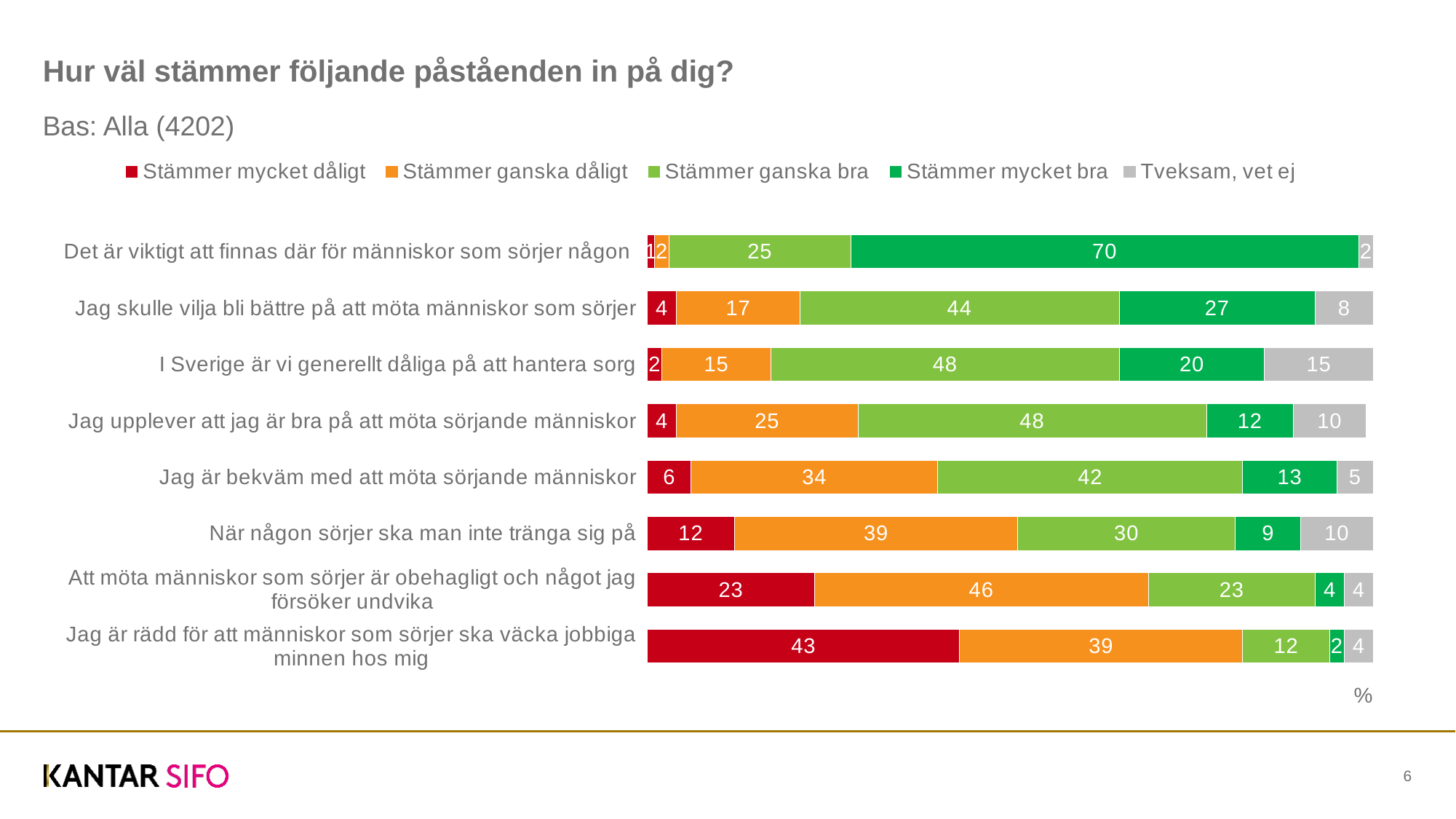
Which statement has the highest value for "Stämmer mycket dåligt"? Jag är rädd för att människor som sörjer ska väcka jobbiga minnen hos mig Which is larger for "När någon sörjer ska man inte tränga sig på": the "Stämmer ganska dåligt" value or the "Stämmer ganska bra" value? Stämmer ganska dåligt What is the total of the stacked bar for "Jag skulle vilja bli bättre på att möta människor som sörjer"? 100 What is the value for "Stämmer ganska dåligt" for the statement "Jag är bekväm med att möta sörjande människor"? 34 How many series does the legend list? 5 Which statement has the lowest value for "Stämmer mycket bra"? Jag är rädd för att människor som sörjer ska väcka jobbiga minnen hos mig How many statements (categories) are plotted in the chart? 8 What kind of chart is shown on the slide? Stacked bar chart Which colour represents "Tveksam, vet ej" in the legend? Grey What is the difference between the "Stämmer ganska dåligt" value and the "Stämmer ganska bra" value for "Att möta människor som sörjer är obehagligt och något jag försöker undvika"? 23 What is the value for "Stämmer mycket bra" for the statement "Det är viktigt att finnas där för människor som sörjer någon"? 70 What is the value for "Tveksam, vet ej" for the statement "I Sverige är vi generellt dåliga på att hantera sorg"? 15